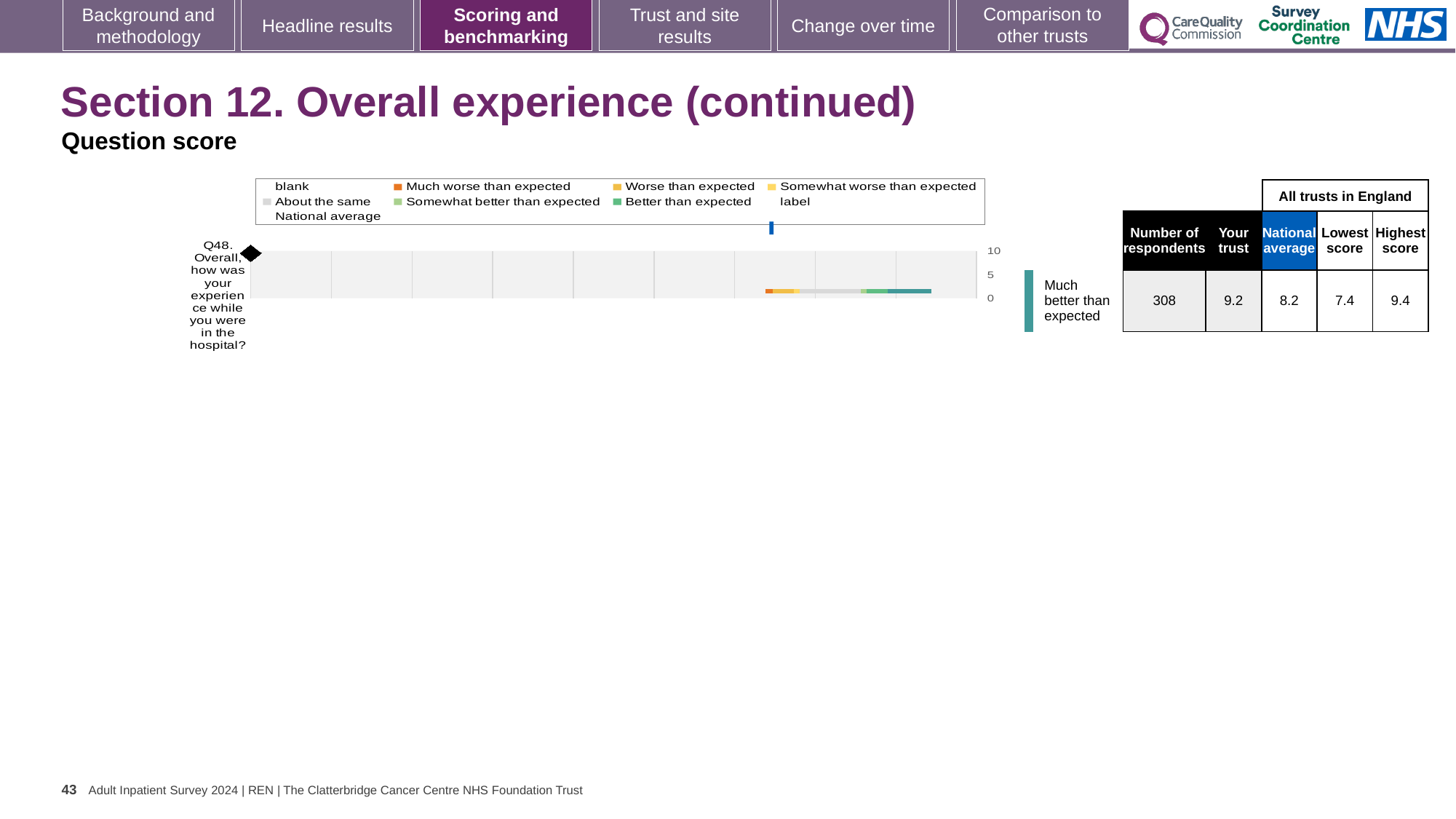
What is the 'Your trust' score for Q48? 9.2 What is the difference between the 'Your trust' score and the national average for Q48? 1.0 What is the national average score for Q48? 8.2 What kind of chart is shown for Q48 on this slide? bar chart Which question number is plotted in the chart? Q48 Is the 'Your trust' score for Q48 greater or less than 5? greater Which is larger for Q48, the 'Your trust' score or the national average? Your trust What is the highest score among all trusts in England for Q48? 9.4 What benchmark category label is shown next to the Q48 bar? Much better than expected What is the lowest score among all trusts in England for Q48? 7.4 How many respondents answered Q48? 308 How many survey questions are plotted in the chart? 1